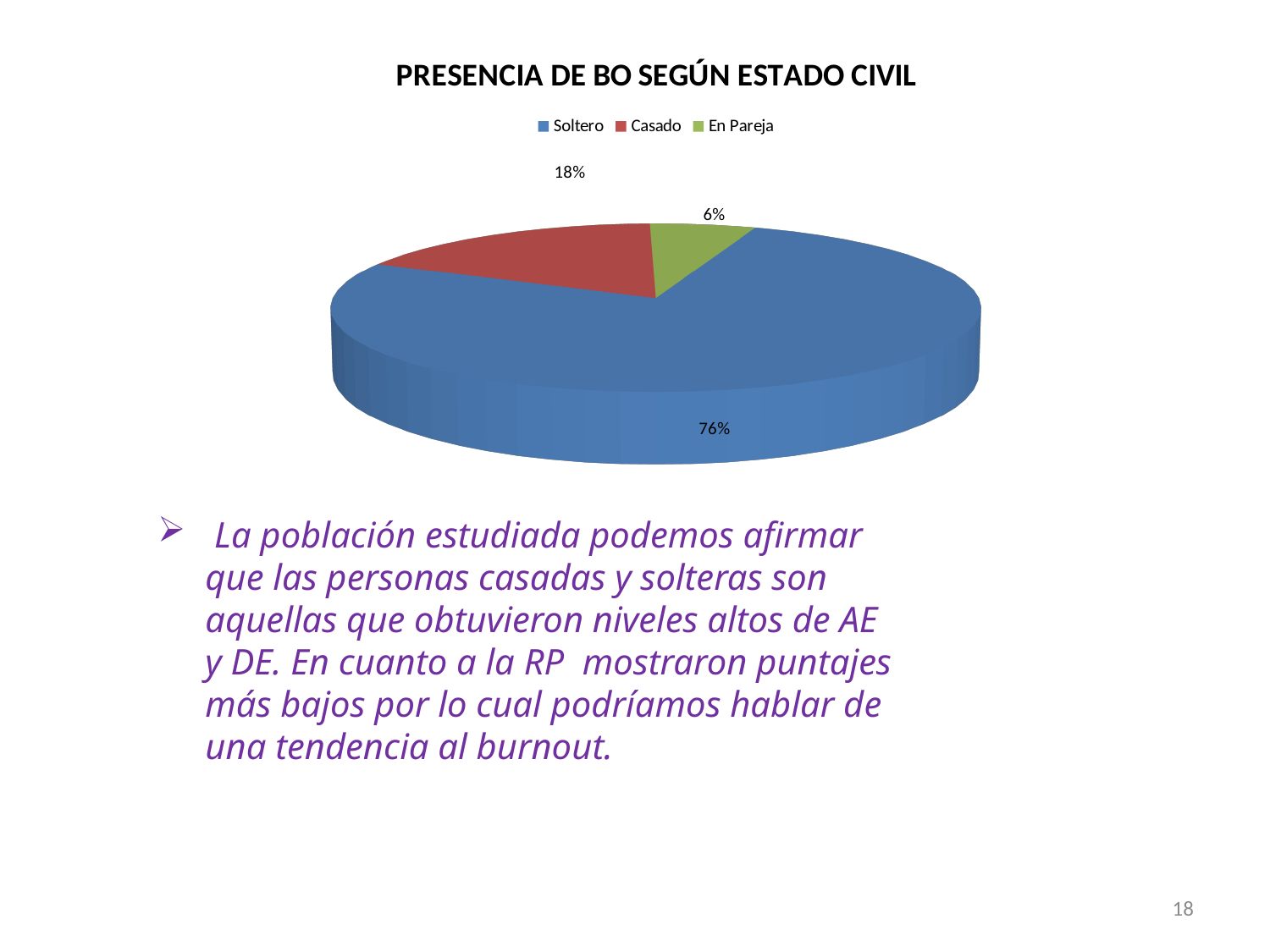
What colour is the Soltero slice? blue What type of chart is shown on the slide? pie chart What percentage of the pie corresponds to Casado? 18% Which category has the smallest share of the pie? En Pareja How many categories does the legend list? 3 What is the difference in percentage points between Casado and En Pareja? 12 What percentage of the pie corresponds to Soltero? 76% Which category has the largest share of the pie? Soltero Which is larger, the share for Casado or the share for En Pareja? Casado What is the difference in percentage points between Soltero and Casado? 58 What is the title of the chart? PRESENCIA DE BO SEGÚN ESTADO CIVIL What percentage of the pie corresponds to En Pareja? 6%